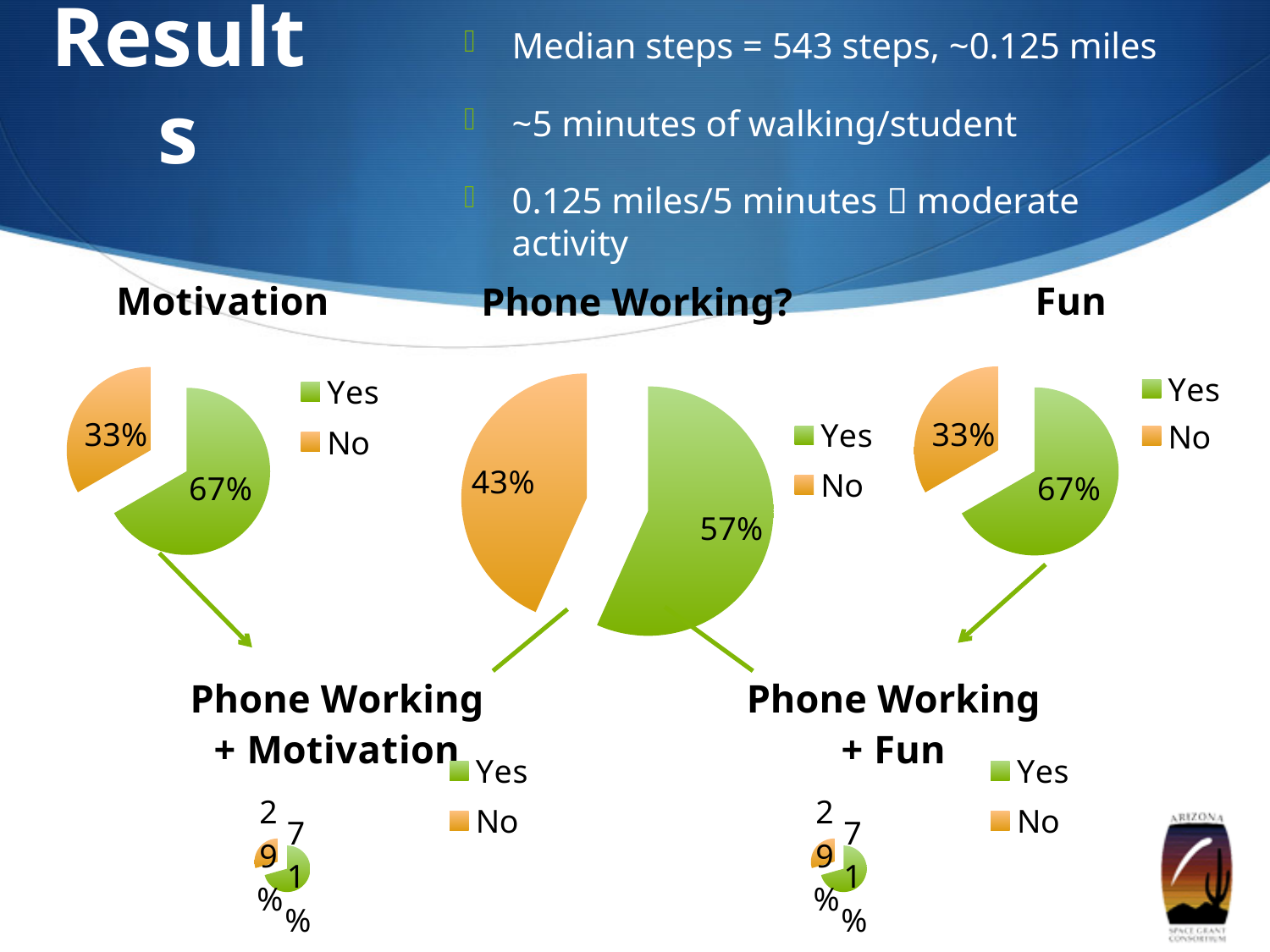
In the Motivation pie chart, what percentage answered No? 33% In the Phone Working? pie chart, what percentage answered No? 43% In the Fun pie chart, what is the difference between the Yes and No percentages? 34% What type of chart is used for the Motivation chart? Pie chart In the Fun pie chart, what is the share of the No slice? 33% In the Phone Working? pie chart, which slice is larger, Yes or No? Yes In the Phone Working? pie chart, what is the difference between the Yes and No percentages? 14% In the Fun pie chart, what percentage answered Yes? 67% How many entries does the legend of the Fun chart list? 2 In the Phone Working? pie chart, what share of the pie is Yes? 57% In the Motivation pie chart, which category has the smallest slice? No In the Motivation pie chart, what percentage answered Yes? 67%